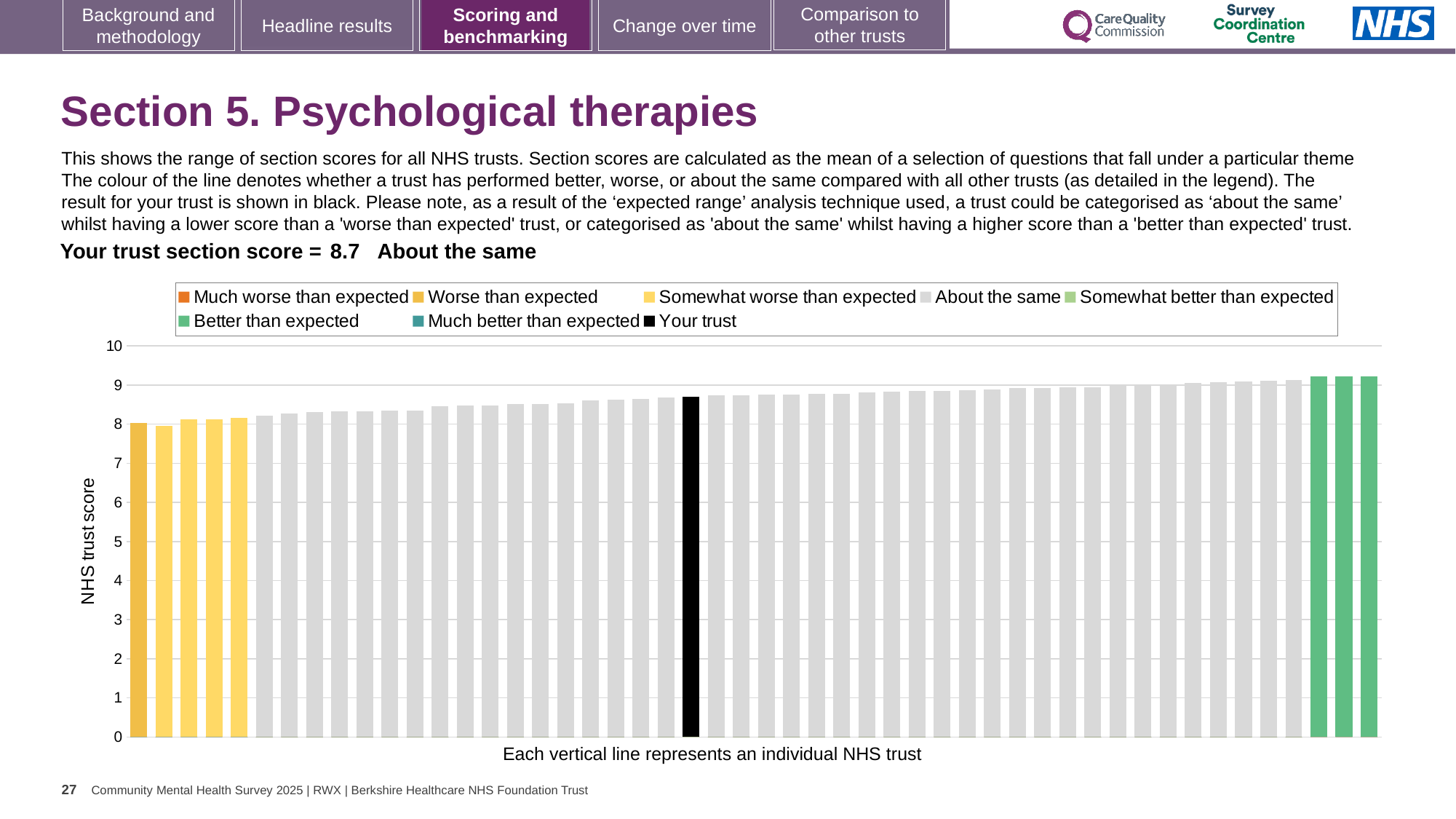
Which category is your trust placed in for this section? About the same How many entries does the chart legend list? 8 Is the value of the first (orange) bar on the left greater or less than 9? less How many green bars (better than expected) are shown in the chart? 3 What colour is the bar representing your trust? black What kind of chart is shown on the slide? bar chart What is the label on the vertical axis of the chart? NHS trust score What is the section score for your trust shown on the slide? 8.7 How many orange bars (much worse than expected) are shown in the chart? 0 Do the bar values rise or fall from left to right along the x axis? rise Is the value of the black bar (your trust) greater or less than 9? less Is the value of the black bar (your trust) greater or less than 8? greater